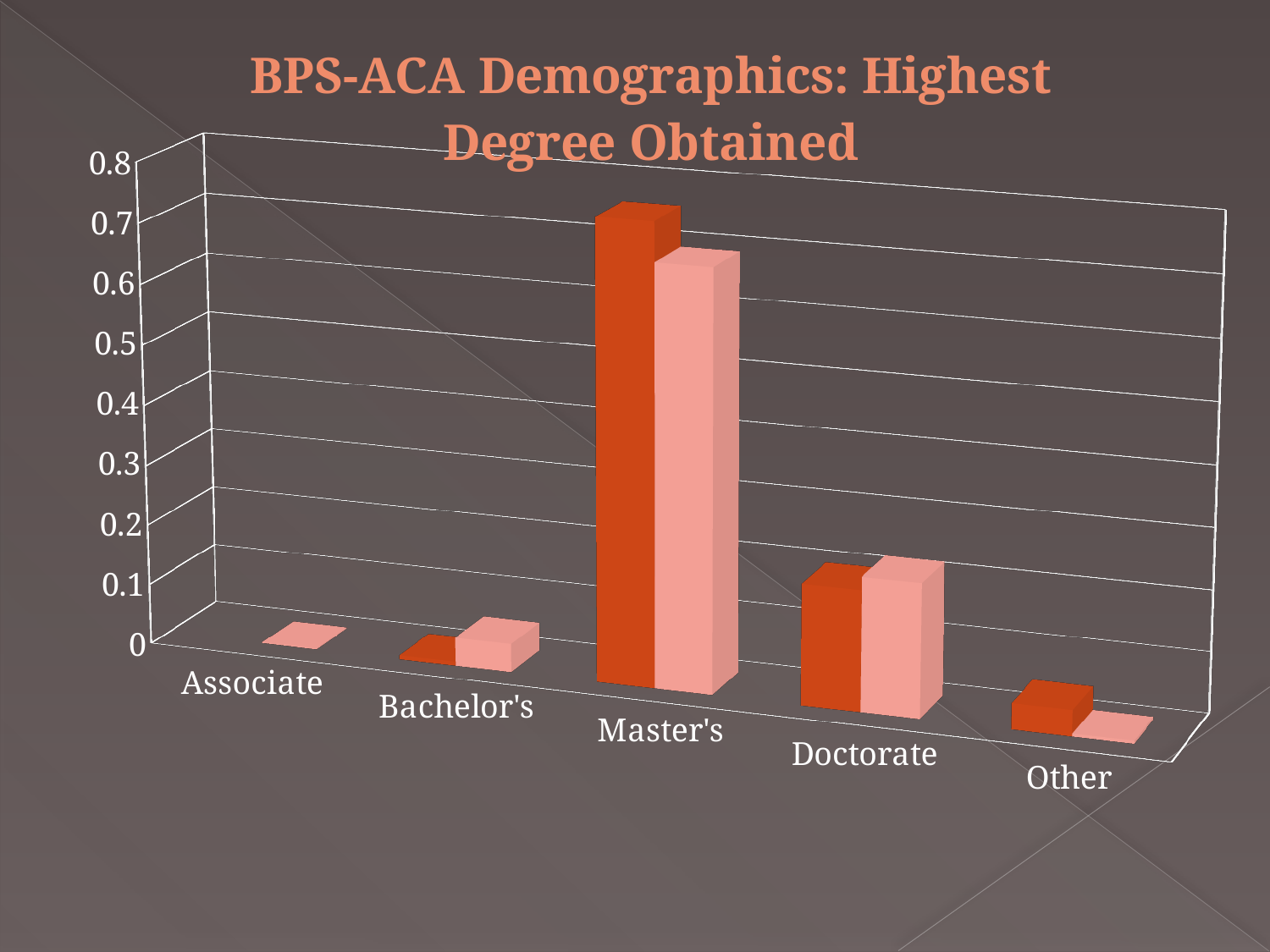
Which has a larger light pink bar, Doctorate or Bachelor's? Doctorate What kind of chart is shown on the slide? bar chart How many degree categories are shown on the x axis? 5 Which degree category has the lowest bars? Associate What is the highest value shown on the vertical axis? 0.8 Is the light pink bar for Master's greater or less than 0.5? greater Is the light pink bar for Bachelor's greater or less than 0.1? less Which has a larger dark orange bar, Master's or Doctorate? Master's Which degree category has the highest bars? Master's What is the title of the chart? BPS-ACA Demographics: Highest Degree Obtained Is the dark orange bar for Master's greater or less than 0.6? greater